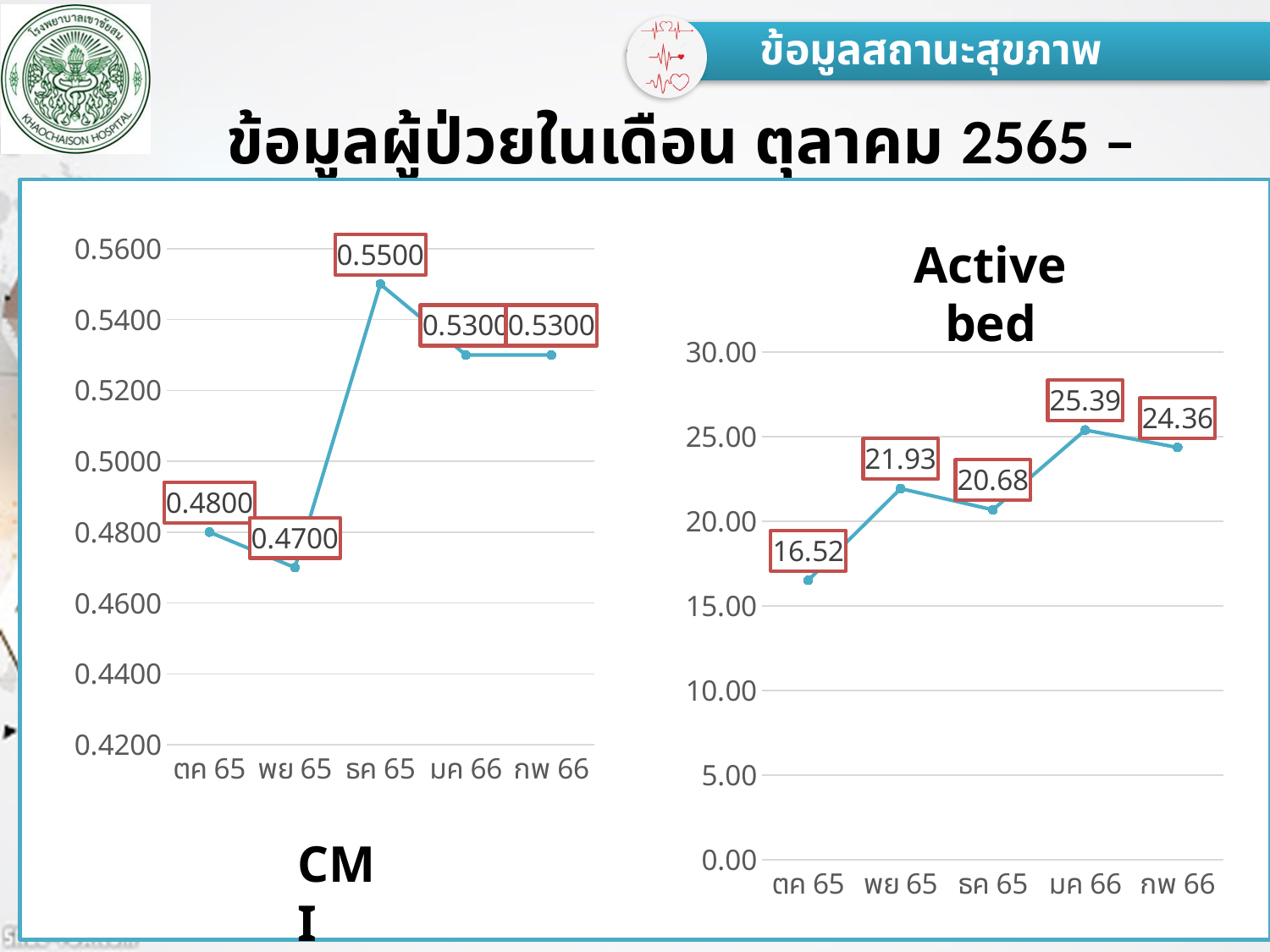
How many months are plotted in the Active bed chart? 5 In the Active bed chart, what is the value for มค 66? 25.39 In the Active bed chart, which is larger, the value for พย 65 or the value for ธค 65? พย 65 In the CMI chart, what is the value for ธค 65? 0.5500 In the Active bed chart, which month has the highest value? มค 66 In the CMI chart, which month has the lowest value? พย 65 In the Active bed chart, what is the difference between the values for มค 66 and ตค 65? 8.87 What kind of chart is the CMI chart? line chart In the CMI chart, what is the value for พย 65? 0.4700 In the Active bed chart, what is the value for ตค 65? 16.52 In the Active bed chart, is the value for กพ 66 greater or less than 20.00? greater In the CMI chart, what is the difference between the values for ธค 65 and พย 65? 0.0800